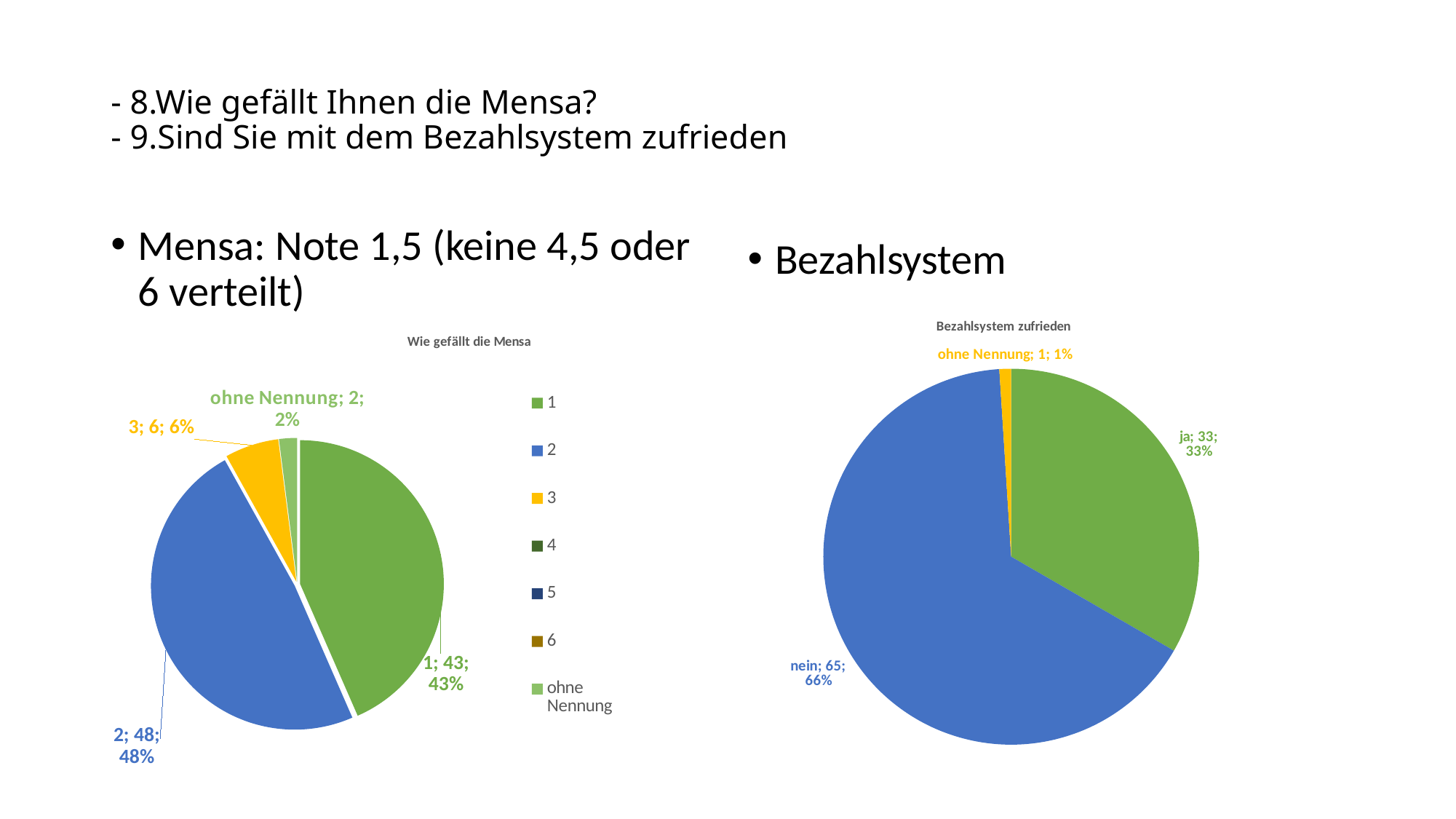
In the chart titled "Wie gefällt die Mensa", what is the value for "ohne Nennung"? 2 What kind of chart is the chart titled "Bezahlsystem zufrieden"? pie chart In the chart titled "Bezahlsystem zufrieden", which is larger, "ja" or "nein"? nein In the chart titled "Wie gefällt die Mensa", what is the value for category 2? 48 In the chart titled "Wie gefällt die Mensa", which category has the largest slice? 2 In the chart titled "Bezahlsystem zufrieden", which category has the smallest slice? ohne Nennung In the chart titled "Bezahlsystem zufrieden", how many slices does the pie have? 3 In the chart titled "Wie gefällt die Mensa", how many entries does the legend list? 7 In the chart titled "Bezahlsystem zufrieden", what is the value for "nein"? 65 In the chart titled "Wie gefällt die Mensa", what is the difference between the values for category 2 and category 1? 5 In the chart titled "Bezahlsystem zufrieden", what share of the pie does "ja" have? 33% In the chart titled "Wie gefällt die Mensa", what share of the pie does category 1 have? 43%